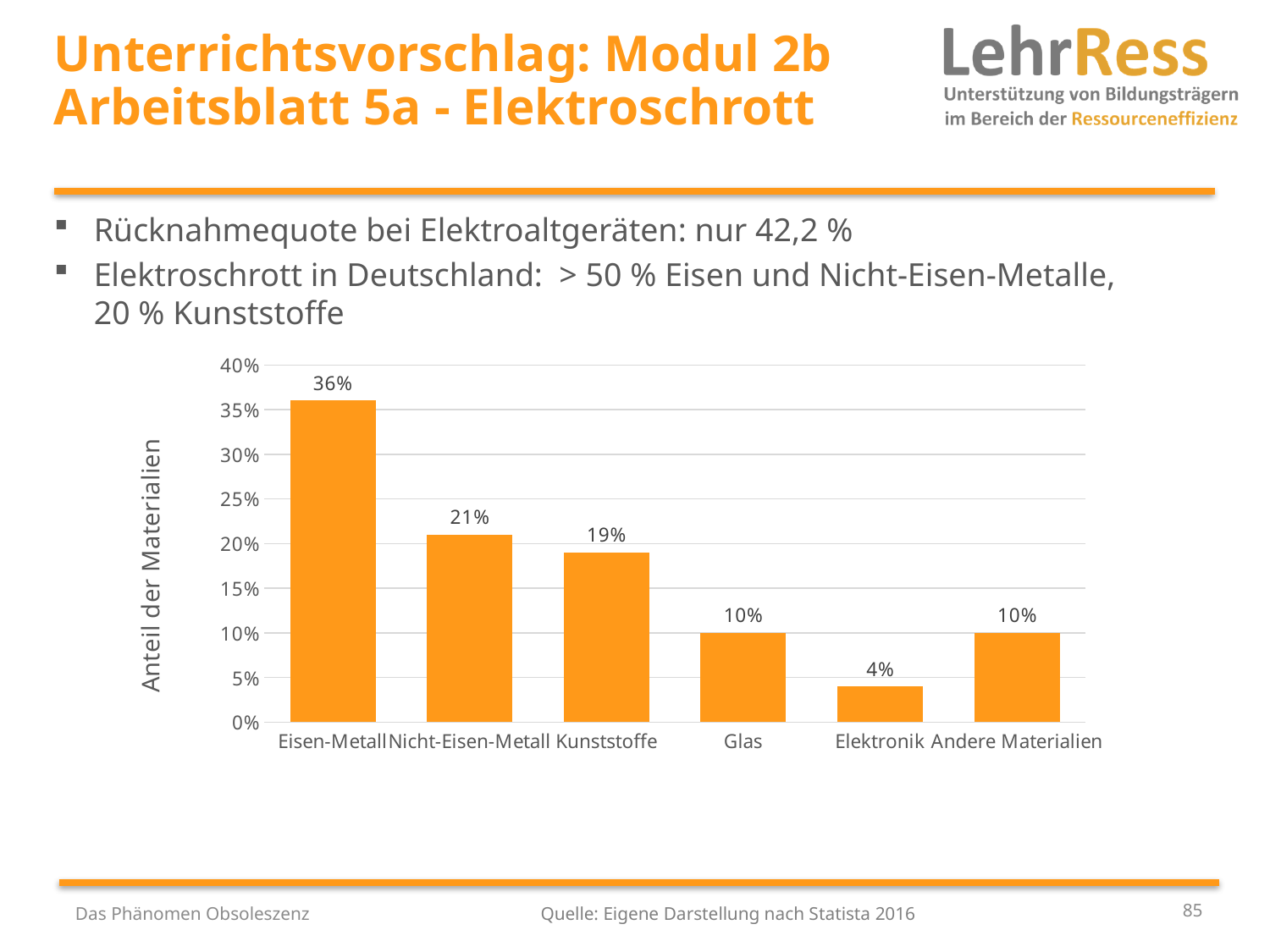
Is the value for Nicht-Eisen-Metall greater or less than 25%? less Which category has the lowest value? Elektronik How many categories are shown on the x axis? 6 Which category has the highest value? Eisen-Metall What is the label of the vertical axis? Anteil der Materialien Which is larger, the value for Kunststoffe or the value for Glas? Kunststoffe What is the value for Elektronik? 4% What kind of chart is shown on the slide? bar chart What is the difference between the values for Eisen-Metall and Nicht-Eisen-Metall? 15% What is the value for Nicht-Eisen-Metall? 21% What is the value for Kunststoffe? 19% What is the value for Eisen-Metall? 36%